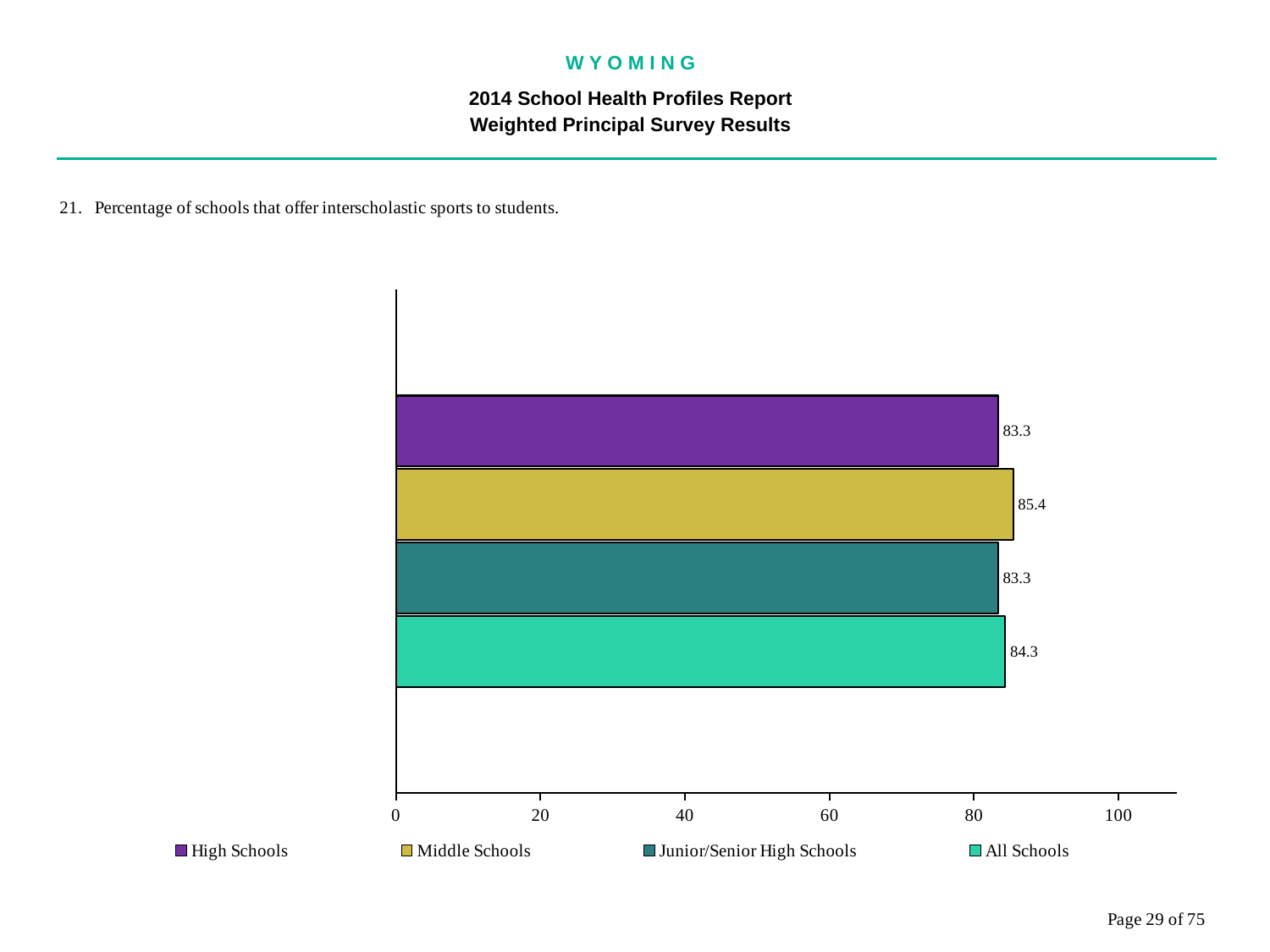
What is the difference between the Middle Schools value and the High Schools value? 2.1 What is the difference between the All Schools value and the Junior/Senior High Schools value? 1.0 How many bars are plotted in the chart? 4 Which is larger, the value for Middle Schools or the value for All Schools? Middle Schools What is the value for Middle Schools? 85.4 What is the value for All Schools? 84.3 Which school type has the highest percentage of schools offering interscholastic sports? Middle Schools What is the value for Junior/Senior High Schools? 83.3 How many series does the legend list? 4 What is the value for High Schools? 83.3 Is the value for High Schools greater or less than 80? greater What kind of chart is shown on the slide? bar chart